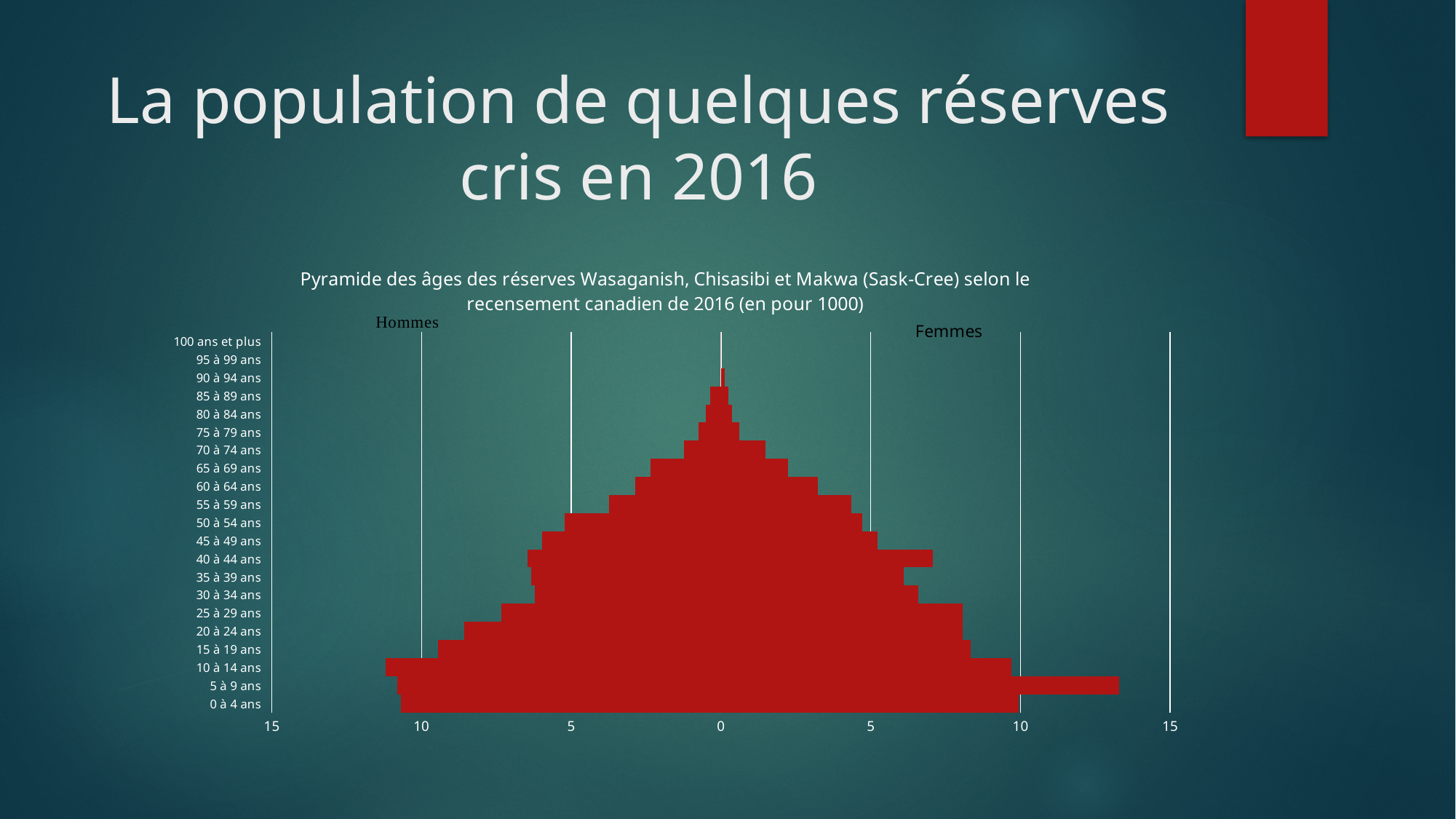
Which age group has the highest value on the Femmes side? 5 à 9 ans Which side of the pyramid shows the men (Hommes): left or right? left How many age groups are listed on the vertical axis of the chart? 21 What kind of chart is shown on the slide? bar chart Is the Femmes value for 5 à 9 ans greater or less than 10? greater Is the Femmes value for 60 à 64 ans greater or less than 5? less Is the Femmes value for 40 à 44 ans greater or less than 5? greater What is the title of the chart? Pyramide des âges des réserves Wasaganish, Chisasibi et Makwa (Sask-Cree) selon le recensement canadien de 2016 (en pour 1000) As the age groups get older, do the bars generally get longer or shorter? shorter On the Femmes side, which is larger: the value for 5 à 9 ans or the value for 10 à 14 ans? 5 à 9 ans